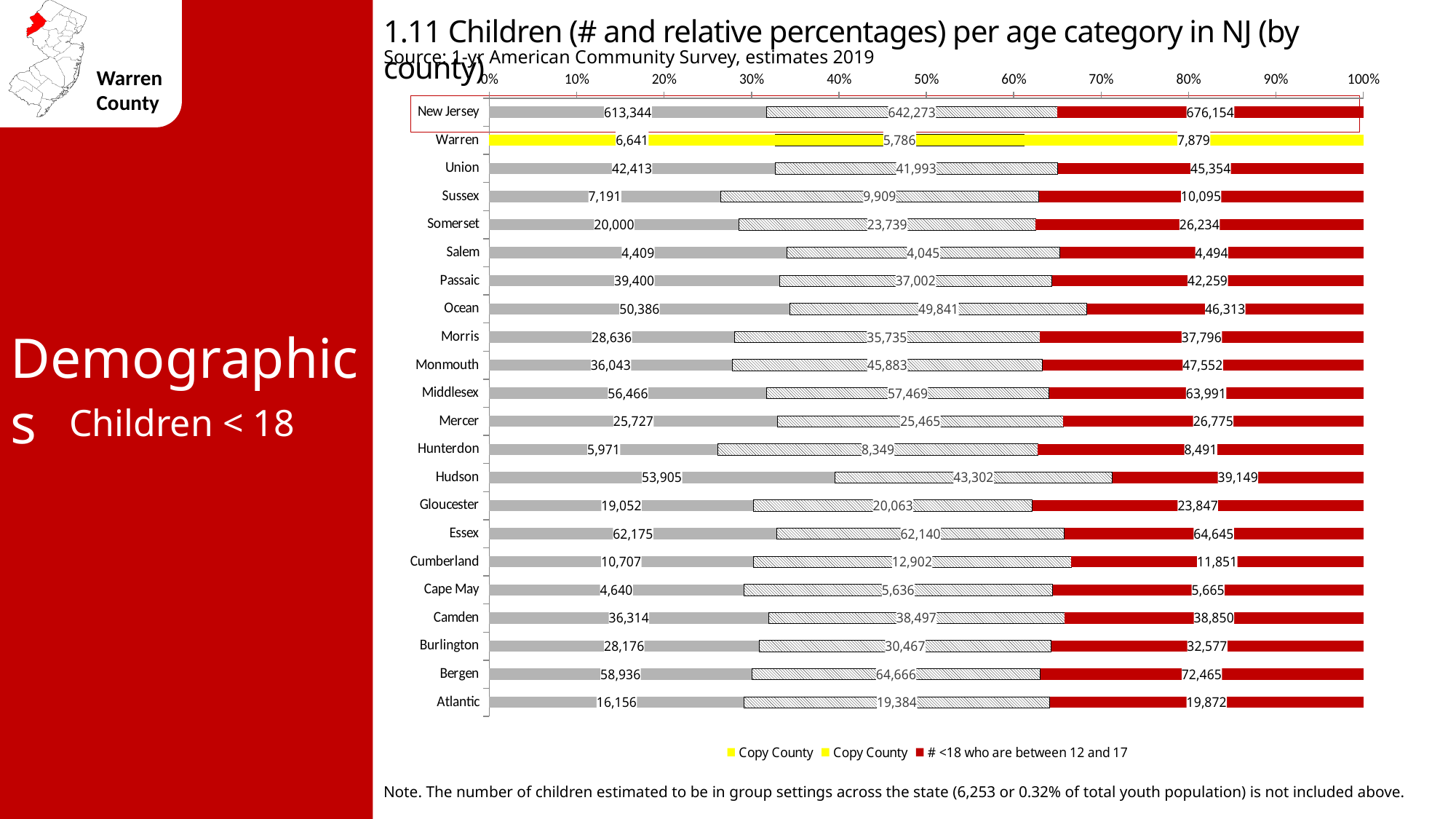
What is the value of the middle segment for Warren? 5,786 What is the value of the red segment (# <18 who are between 12 and 17) for Warren? 7,879 Which row of the chart is highlighted in yellow? Warren What is the total of the three segments in the Warren bar? 20,306 How many categories (rows) are plotted on the chart? 22 How many series does the legend list? 3 For Hudson, which is larger: the first (leftmost) segment or the red segment? the first segment (53,905) What is the value of the first (leftmost) segment for Warren? 6,641 Among the counties (excluding New Jersey), which has the lowest value in the red segment? Salem What kind of chart is shown on the slide? bar chart What is the value of the red segment for New Jersey? 676,154 What is the difference between the red segment and the first segment for Bergen? 13,529